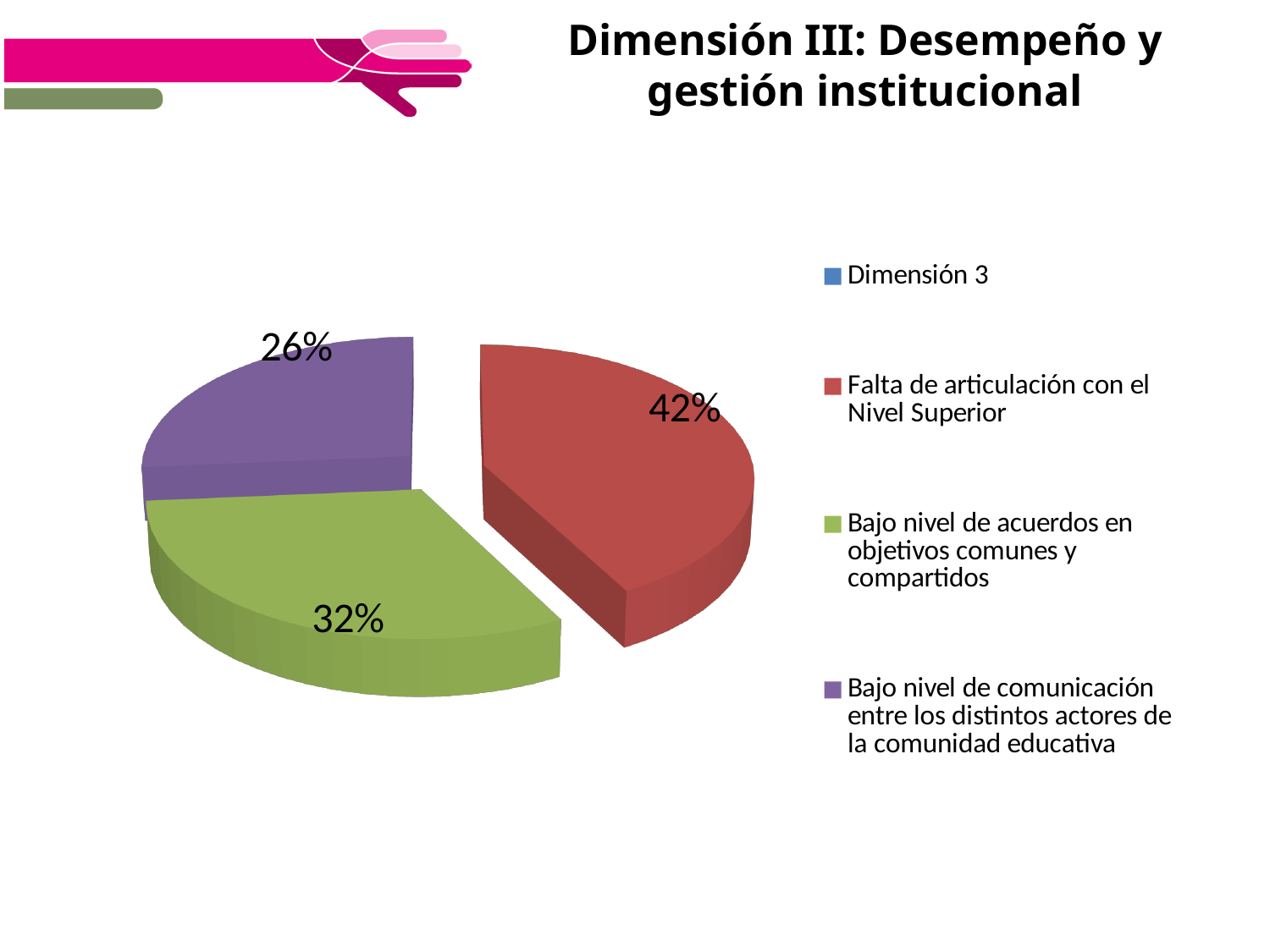
What share of the pie does "Falta de articulación con el Nivel Superior" represent? 42% Which category has the largest slice of the pie? Falta de articulación con el Nivel Superior What is the difference in percentage points between the largest slice (42%) and the smallest visible slice (26%)? 16 How many slices with data labels are visible in the pie chart? 3 What share of the pie does "Bajo nivel de acuerdos en objetivos comunes y compartidos" represent? 32% What share of the pie does "Bajo nivel de comunicación entre los distintos actores de la comunidad educativa" represent? 26% Which category has the smallest visible slice of the pie? Bajo nivel de comunicación entre los distintos actores de la comunidad educativa What kind of chart is shown on the slide? Pie chart How many entries does the legend list? 4 What is the difference in percentage points between "Falta de articulación con el Nivel Superior" and "Bajo nivel de acuerdos en objetivos comunes y compartidos"? 10 Which is larger: the slice for "Bajo nivel de acuerdos en objetivos comunes y compartidos" or the slice for "Bajo nivel de comunicación entre los distintos actores de la comunidad educativa"? Bajo nivel de acuerdos en objetivos comunes y compartidos What colour is the slice labelled 42%? Red